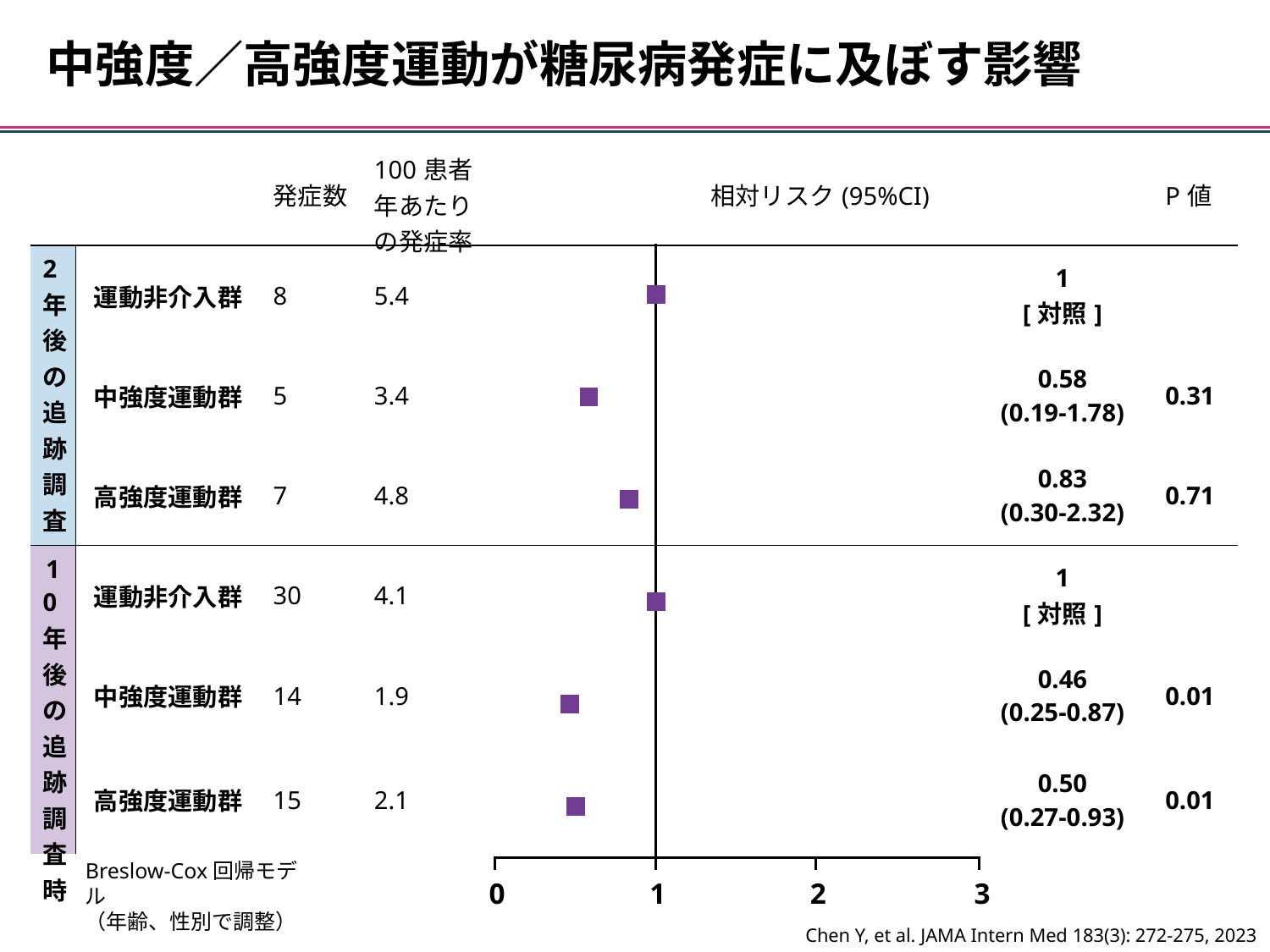
What is the P値 for the 高強度運動群 in the 2年後の追跡調査 group? 0.71 What is the 95% CI for the 高強度運動群 in the 10年後の追跡調査時 group? (0.27-0.93) How many data points are plotted on the relative risk chart? 6 What is the P値 for the 中強度運動群 in the 10年後の追跡調査時 group? 0.01 Is the relative risk for the 高強度運動群 in the 10年後の追跡調査時 group greater or less than 1? less What is the 100患者年あたりの発症率 for the 高強度運動群 in the 2年後の追跡調査 group? 4.8 Which group has the lowest relative risk on the plot? 中強度運動群 (10年後の追跡調査時) What is the relative risk (相対リスク) for the 中強度運動群 in the 2年後の追跡調査 group? 0.58 What is the maximum value shown on the relative risk axis? 3 What is the 発症数 for the 運動非介入群 in the 10年後の追跡調査時 group? 30 What is the difference in relative risk between the 高強度運動群 and the 中強度運動群 in the 2年後の追跡調査 group? 0.25 In the 2年後の追跡調査 group, which has the larger relative risk: 中強度運動群 or 高強度運動群? 高強度運動群